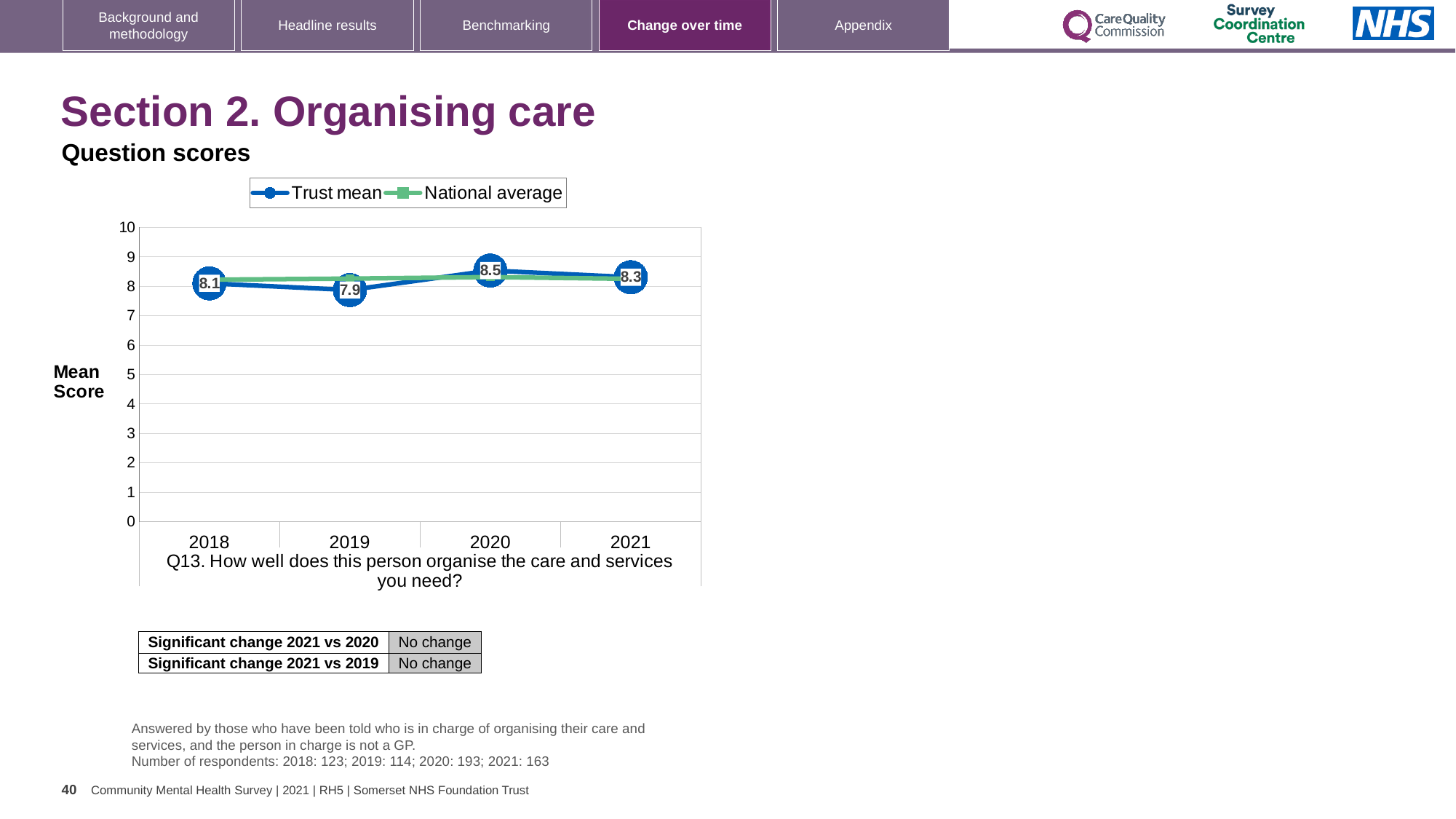
How many series does the legend list? 2 Is the National average value for 2021 greater or less than 9? less How many years are plotted on the x axis? 4 What is the Trust mean score for 2018? 8.1 Which year has the larger Trust mean score, 2018 or 2021? 2021 In which year is the Trust mean score lowest? 2019 What kind of chart is shown? line chart What is the Trust mean score for 2021? 8.3 In which year is the Trust mean score highest? 2020 Does the Trust mean score rise or fall from 2019 to 2020? rise What is the difference between the Trust mean scores for 2020 and 2019? 0.6 What is the Trust mean score for 2019? 7.9